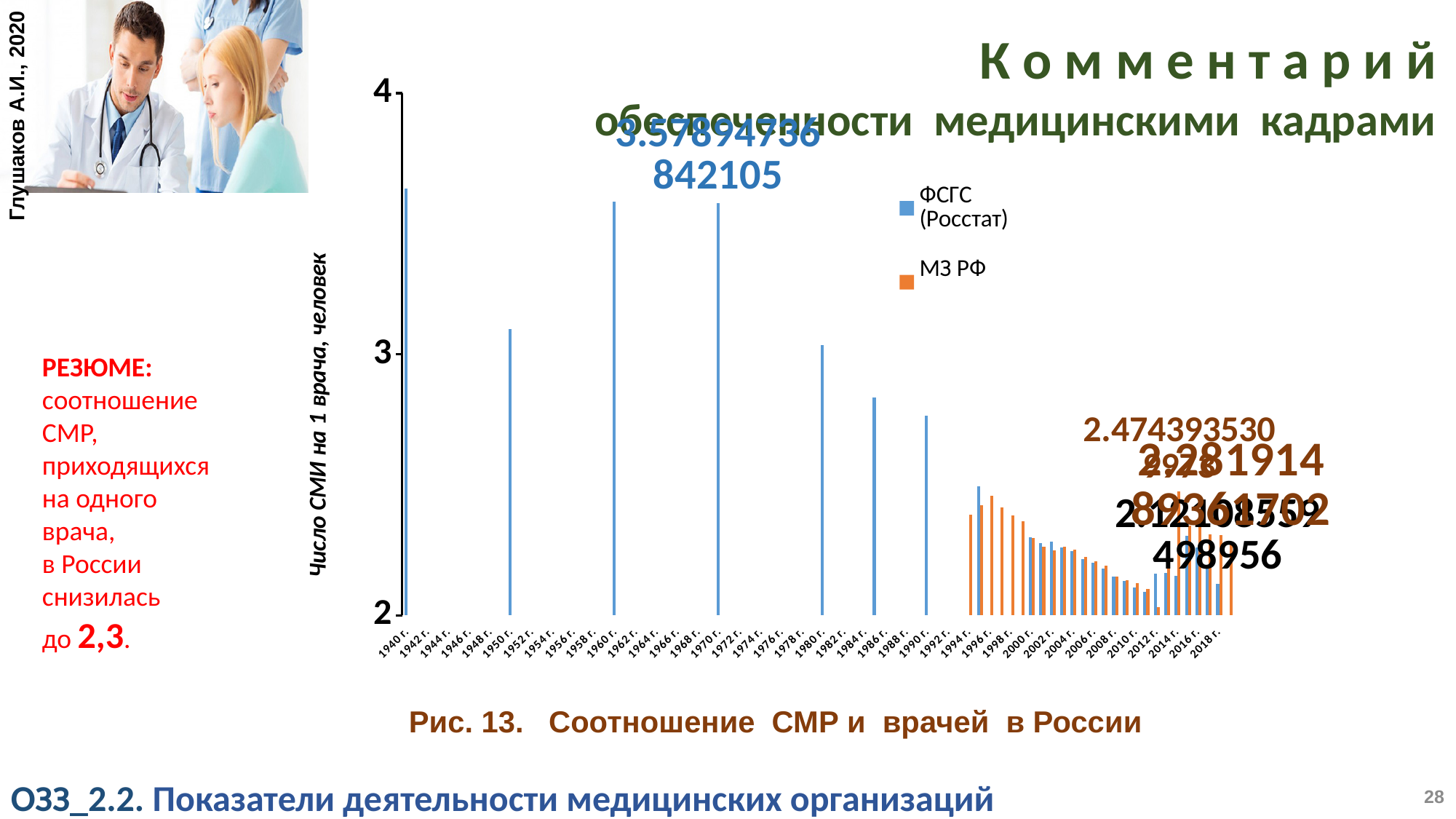
What kind of chart is shown on the slide? bar chart How many series does the legend list? 2 Is the ФСГС (Росстат) value for 1940 г. greater or less than 3? greater What is the label of the vertical axis? Число СМИ на 1 врача, человек Which is larger, the МЗ РФ value for 1996 г. or for 2010 г.? 1996 г. What are the two series named in the legend? ФСГС (Росстат) and МЗ РФ Do the values generally rise or fall from 1940 г. to 2018 г.? fall Is the ФСГС (Росстат) value for 1990 г. greater or less than 3? less Is the МЗ РФ value for 2010 г. greater or less than 3? less Which is larger, the ФСГС (Росстат) value for 1940 г. or for 1990 г.? 1940 г.